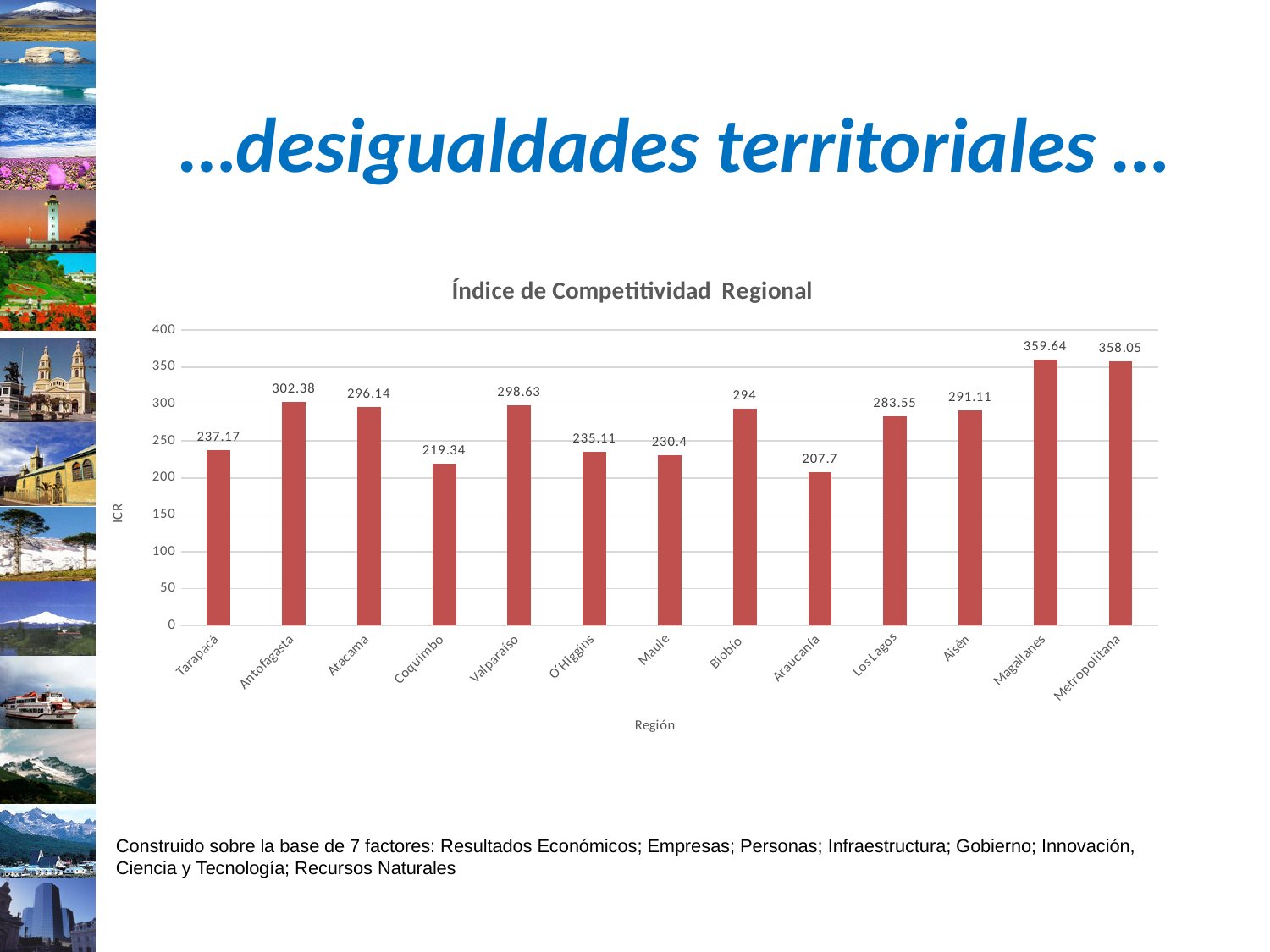
What is the value shown for Araucanía? 207.7 What is the difference between the values for Biobío and Araucanía? 86.3 What is the Índice de Competitividad Regional value for Tarapacá? 237.17 What is the difference between the values for Antofagasta and Tarapacá? 65.21 How many regions are shown in the chart? 13 Which has a larger value, Valparaíso or Coquimbo? Valparaíso What is the value shown for Los Lagos? 283.55 Which region has the highest value in the chart? Magallanes Is the value for Coquimbo greater or less than 250? less Which region has the lowest value in the chart? Araucanía What kind of chart is shown on the slide? bar chart What is the label of the vertical axis of the chart? ICR